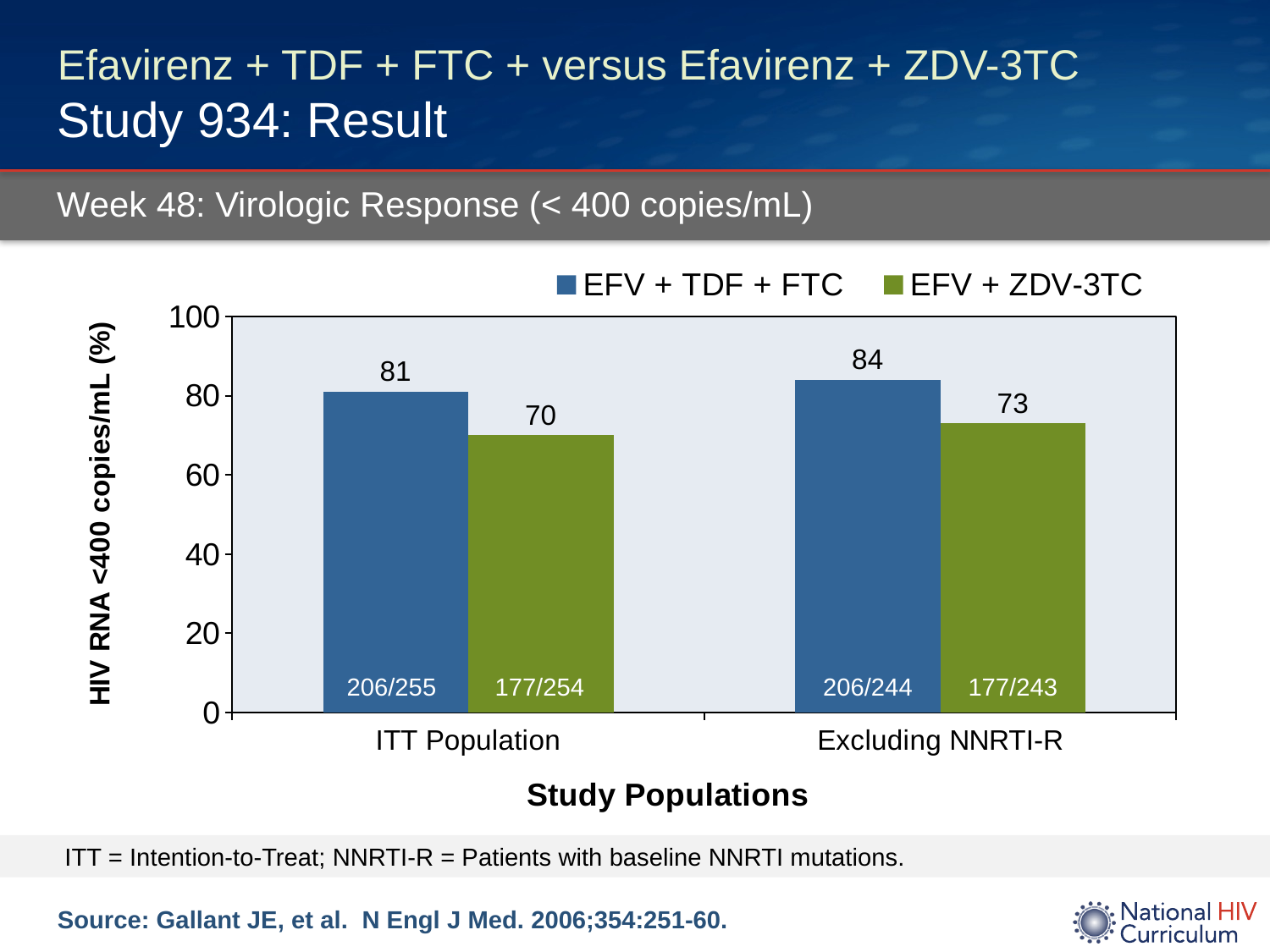
What is the value for EFV + ZDV-3TC in the ITT Population? 70 Which bar has the lowest value on the chart? EFV + ZDV-3TC, ITT Population What is the difference between EFV + TDF + FTC and EFV + ZDV-3TC in the Excluding NNRTI-R population? 11 What is the value for EFV + TDF + FTC in the Excluding NNRTI-R population? 84 Which is larger: EFV + ZDV-3TC in the ITT Population or EFV + ZDV-3TC in the Excluding NNRTI-R population? Excluding NNRTI-R What is the value for EFV + ZDV-3TC in the Excluding NNRTI-R population? 73 How many study population categories are shown on the x axis? 2 How many series does the legend list? 2 What is the difference between EFV + TDF + FTC and EFV + ZDV-3TC in the ITT Population? 11 What kind of chart is shown on the slide? Bar chart Which bar has the highest value on the chart? EFV + TDF + FTC, Excluding NNRTI-R What is the value for EFV + TDF + FTC in the ITT Population? 81